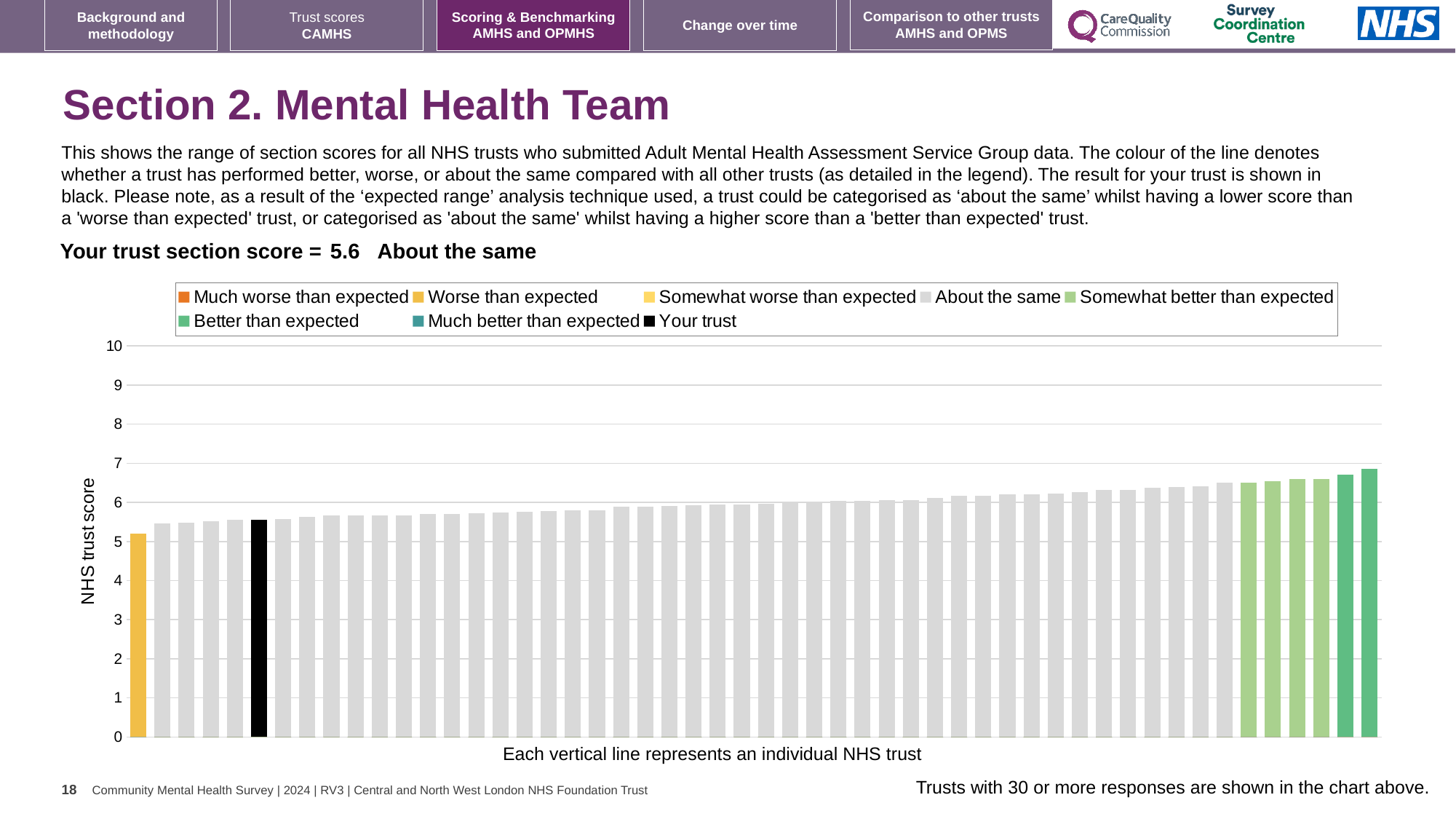
Do the bar values rise or fall from left to right along the x axis? rise Is the value of the tallest bar in the chart greater or less than 7? less What is the label on the vertical axis of the chart? NHS trust score Is the value of the tallest bar in the chart greater or less than 6? greater Is the value of the leftmost (shortest) bar greater or less than 5? greater How many entries does the chart legend list? 8 Is the 'Your trust' bar higher or lower than the leftmost bar in the chart? higher What kind of chart is shown on the slide? bar chart Which category is your trust's section score placed in? About the same What is the section score for your trust? 5.6